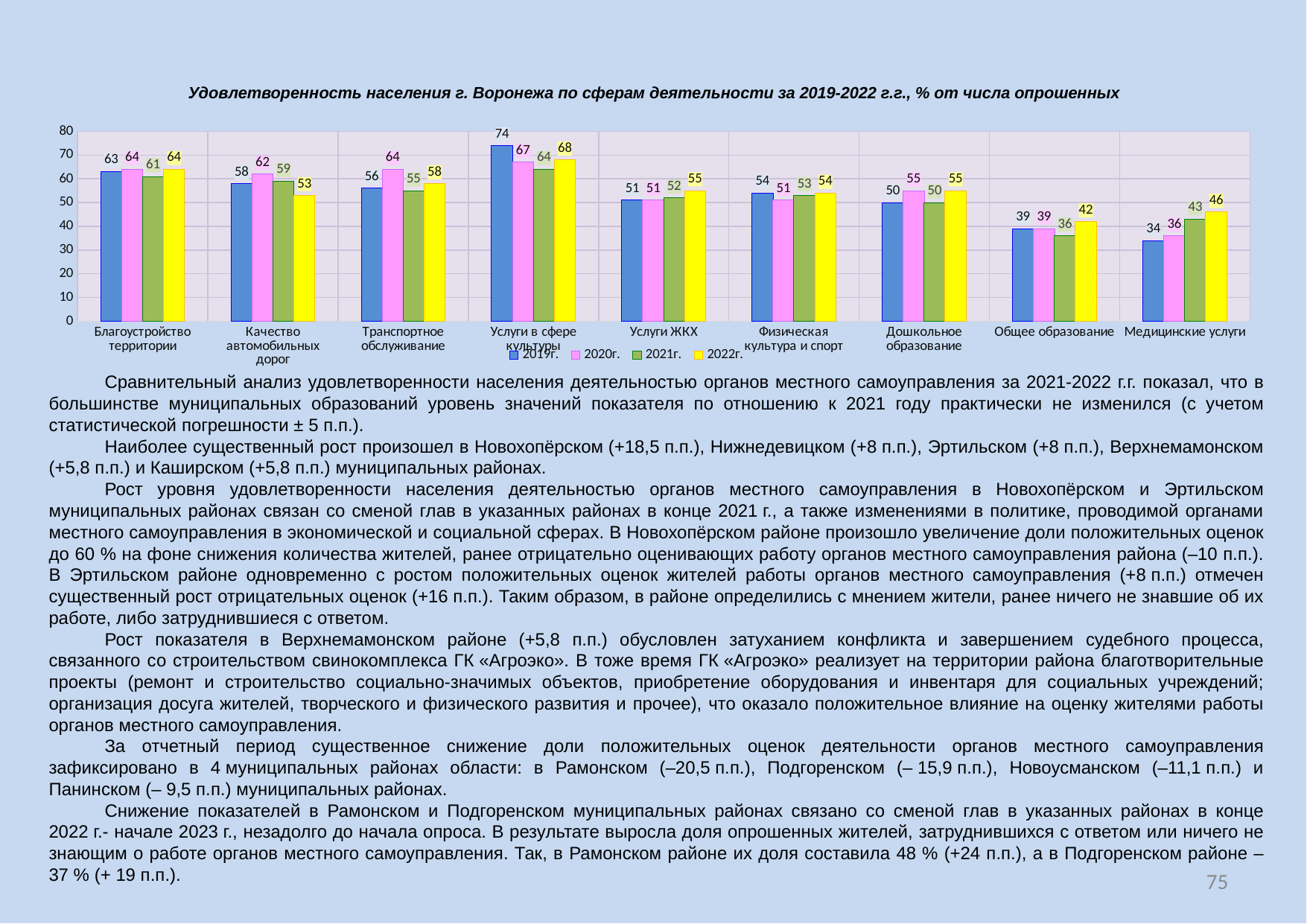
What is the value for 2020г. in the category Транспортное обслуживание? 64 What is the value for 2022г. in the category Медицинские услуги? 46 Do the values for Медицинские услуги rise or fall from 2019г. to 2022г.? rise Which category has the highest value for 2019г.? Услуги в сфере культуры How many categories are shown on the x axis? 9 What type of chart is shown on the slide? bar chart How many series does the legend list? 4 What is the title of the chart? Удовлетворенность населения г. Воронежа по сферам деятельности за 2019-2022 г.г., % от числа опрошенных What is the difference between the 2022г. and 2019г. values for Медицинские услуги? 12 Which is larger for Качество автомобильных дорог: the 2020г. value or the 2022г. value? 2020г. What is the value for 2019г. in the category Услуги в сфере культуры? 74 Which category has the lowest value for 2022г.? Общее образование